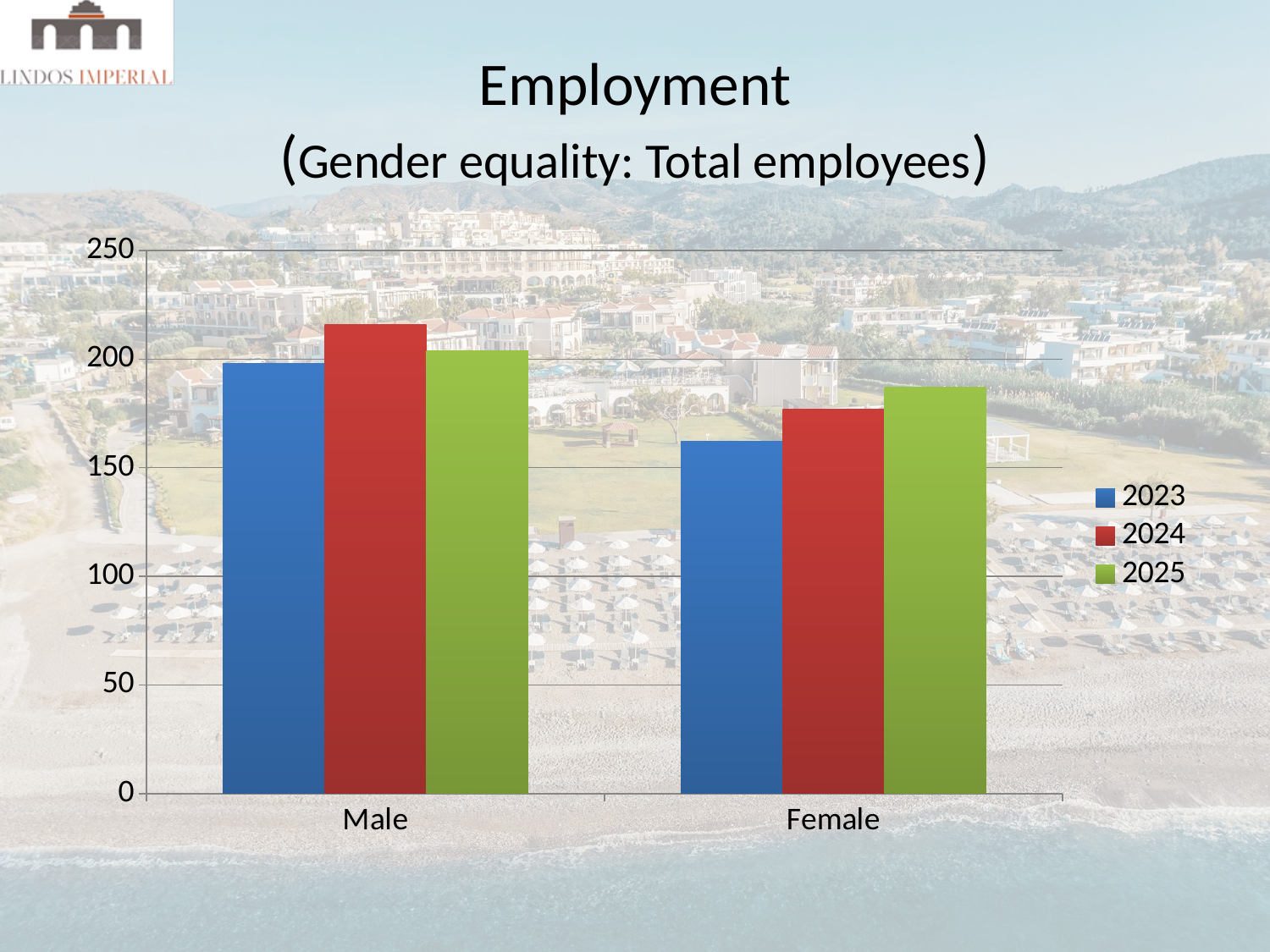
What colour represents the 2025 series in the legend? green Which is larger, the 2023 value for Male or the 2023 value for Female? Male Is the value for Female in 2025 greater or less than 150? greater Which year has the highest value for Female? 2025 How many series does the legend list? 3 Is the value for Male in 2024 greater or less than 200? greater Is the value for Female in 2023 greater or less than 200? less Which is larger, the 2024 value for Male or the 2024 value for Female? Male How many categories are shown on the x axis? 2 Which year has the lowest value for Female? 2023 What kind of chart is shown on the slide? bar chart Which year has the highest value for Male? 2024